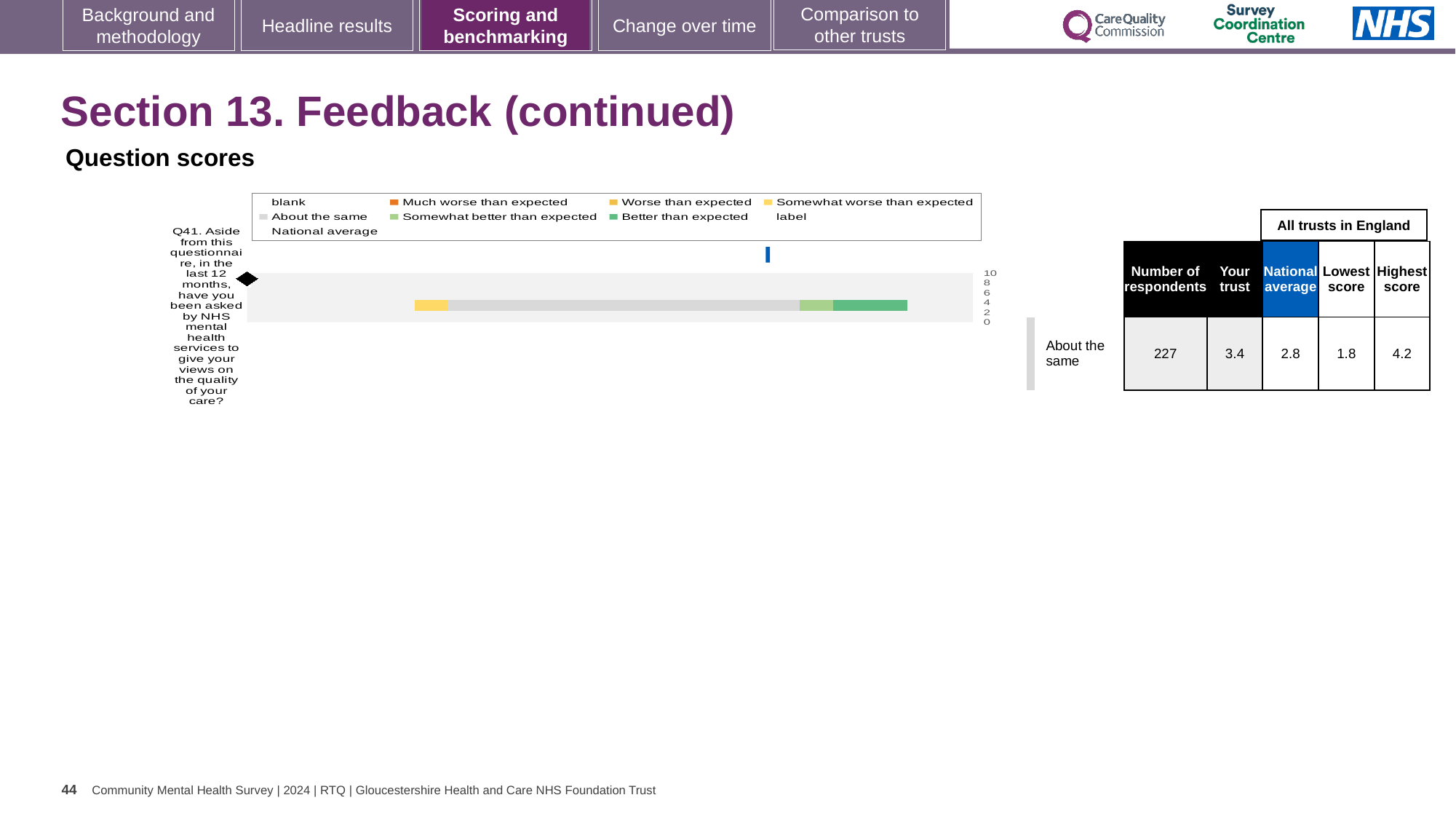
What is the national average score for Q41? 2.8 What colour does the legend use for 'Better than expected'? green What kind of chart is shown on the slide? bar chart What is the 'Your trust' score for Q41? 3.4 What is the difference between the 'Your trust' score and the national average for Q41? 0.6 Which is larger for Q41, the 'Your trust' score or the national average? Your trust What is the number of respondents for Q41 shown in the table? 227 Which question number is plotted in the bar chart? Q41 What is the lowest score among all trusts in England for Q41? 1.8 What benchmark category is Q41 assigned to on the slide? About the same How many questions are plotted in the bar chart? 1 What is the highest score among all trusts in England for Q41? 4.2